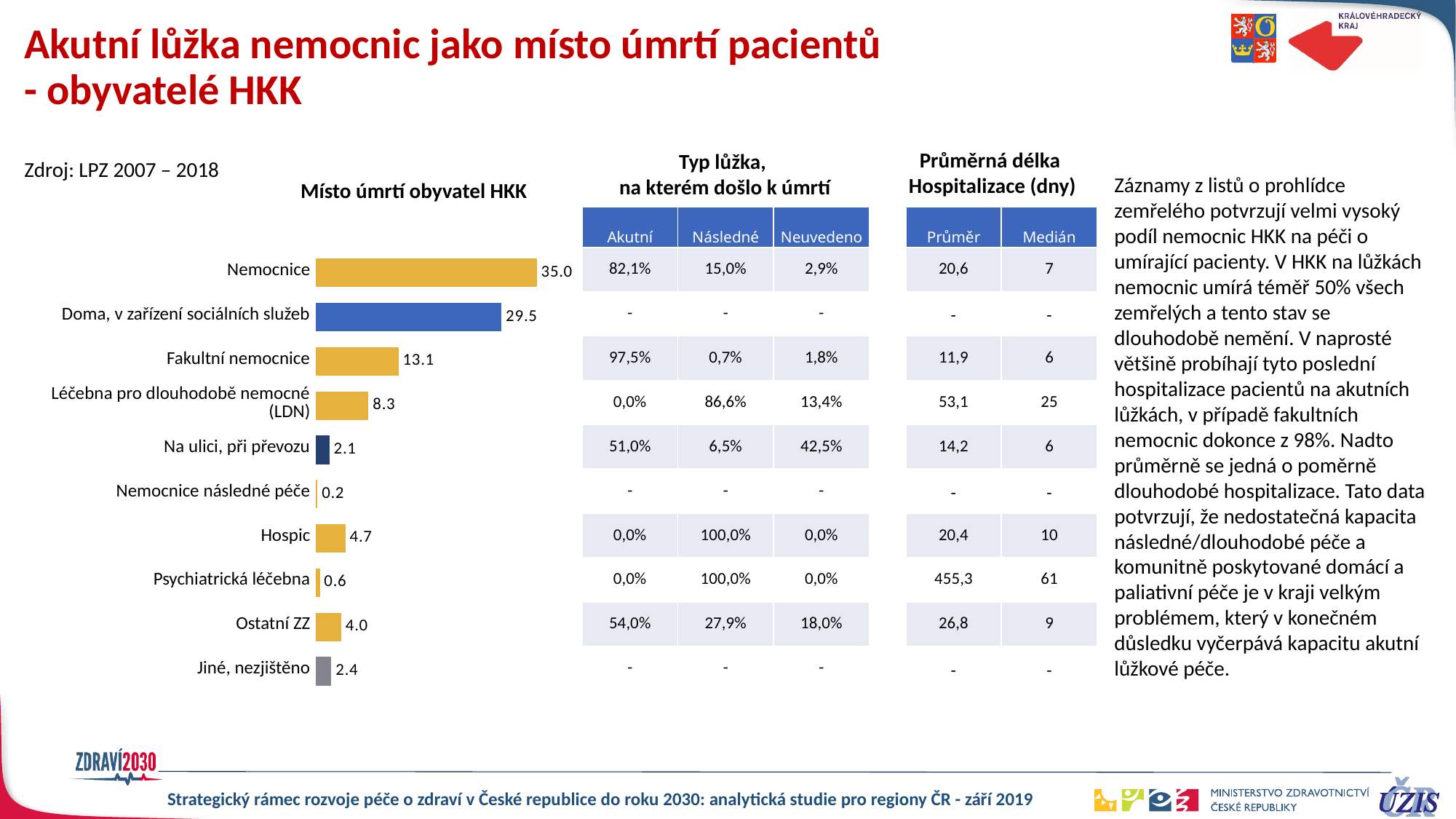
In the chart "Místo úmrtí obyvatel HKK", what is the difference between the values for Fakultní nemocnice and Léčebna pro dlouhodobě nemocné (LDN)? 4.8 In the chart "Místo úmrtí obyvatel HKK", what is the difference between the values for Nemocnice and Doma, v zařízení sociálních služeb? 5.5 Which category has the highest value in the chart "Místo úmrtí obyvatel HKK"? Nemocnice Which category has the lowest value in the chart "Místo úmrtí obyvatel HKK"? Nemocnice následné péče In the chart "Místo úmrtí obyvatel HKK", what is the value for Nemocnice? 35.0 In the chart "Místo úmrtí obyvatel HKK", which is larger: Hospic or Ostatní ZZ? Hospic What is the title of the bar chart on the slide? Místo úmrtí obyvatel HKK In the chart "Místo úmrtí obyvatel HKK", what is the value for Léčebna pro dlouhodobě nemocné (LDN)? 8.3 In the chart "Místo úmrtí obyvatel HKK", what is the value for Doma, v zařízení sociálních služeb? 29.5 In the chart "Místo úmrtí obyvatel HKK", what is the value for Hospic? 4.7 What type of chart is "Místo úmrtí obyvatel HKK"? bar chart How many categories are shown in the chart "Místo úmrtí obyvatel HKK"? 10